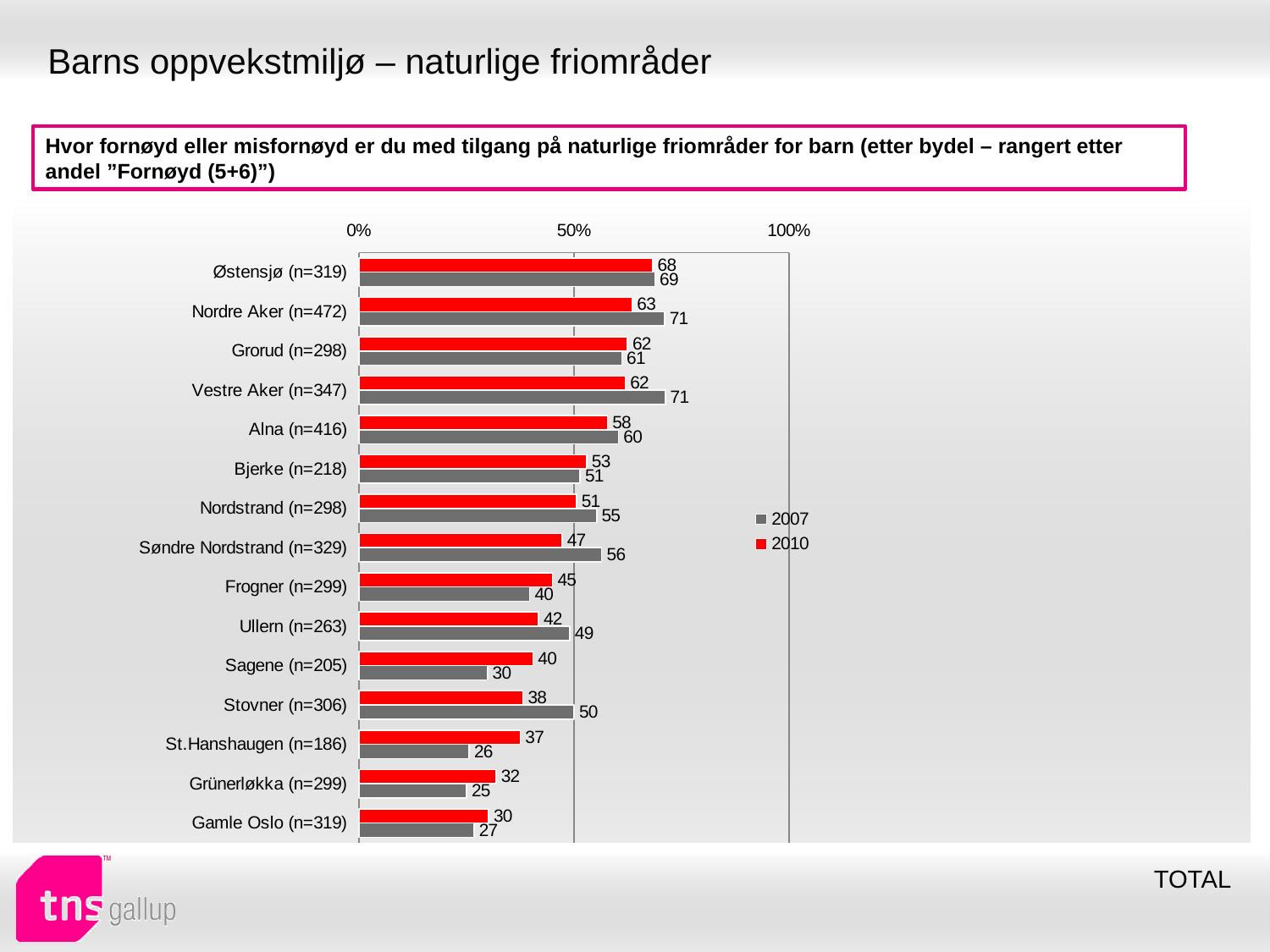
What type of chart is shown on the slide? bar chart What is the 2007 value for Vestre Aker (n=347)? 71 Which bydel has the lowest 2010 value? Gamle Oslo (n=319) Which colour represents the 2007 series in the legend? grey Which bydel has the lowest 2007 value? Grünerløkka (n=299) For Sagene (n=205), which is larger: the 2010 value or the 2007 value? 2010 What is the difference between the 2007 and 2010 values for Stovner (n=306)? 12 What is the 2007 value for Stovner (n=306)? 50 How many bydeler (categories) are shown in the chart? 15 How many series does the legend list? 2 Which bydel has the highest 2010 value? Østensjø (n=319) What is the 2010 value for Østensjø (n=319)? 68